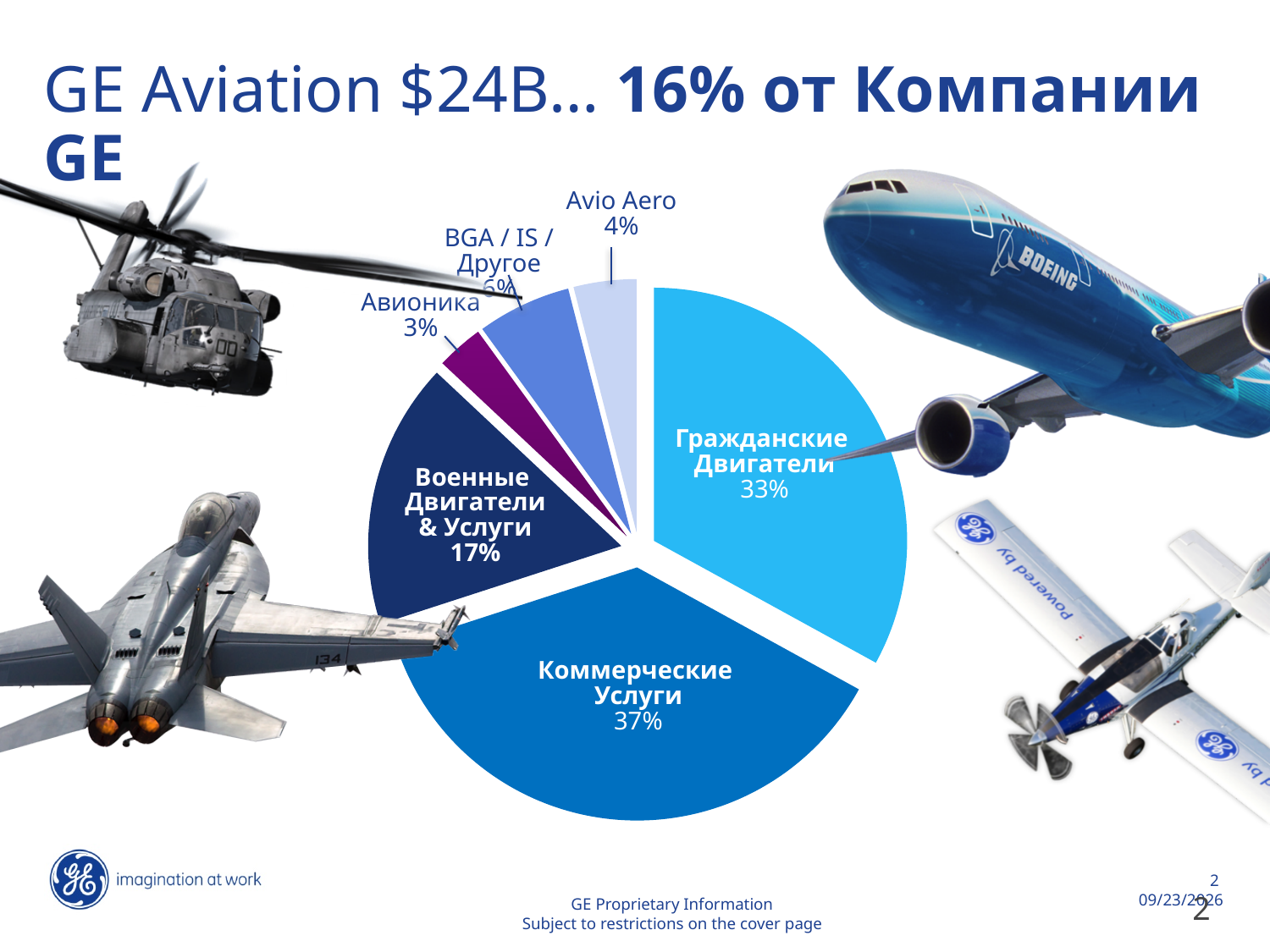
What is the combined share of Гражданские Двигатели, Коммерческие Услуги and Военные Двигатели & Услуги? 87% Which slice of the pie is the smallest? Авионика What kind of chart is shown on the slide? pie chart What share of the pie does Гражданские Двигатели represent? 33% Which is larger: Гражданские Двигатели or Военные Двигатели & Услуги? Гражданские Двигатели Which slice of the pie is the largest? Коммерческие Услуги What is the value shown for Военные Двигатели & Услуги? 17% What share of the pie does Коммерческие Услуги represent? 37% What is the difference in percentage points between Коммерческие Услуги and Гражданские Двигатели? 4 What is the value shown for Avio Aero? 4% What is the value shown for Авионика? 3% How many slices does the pie chart have? 6